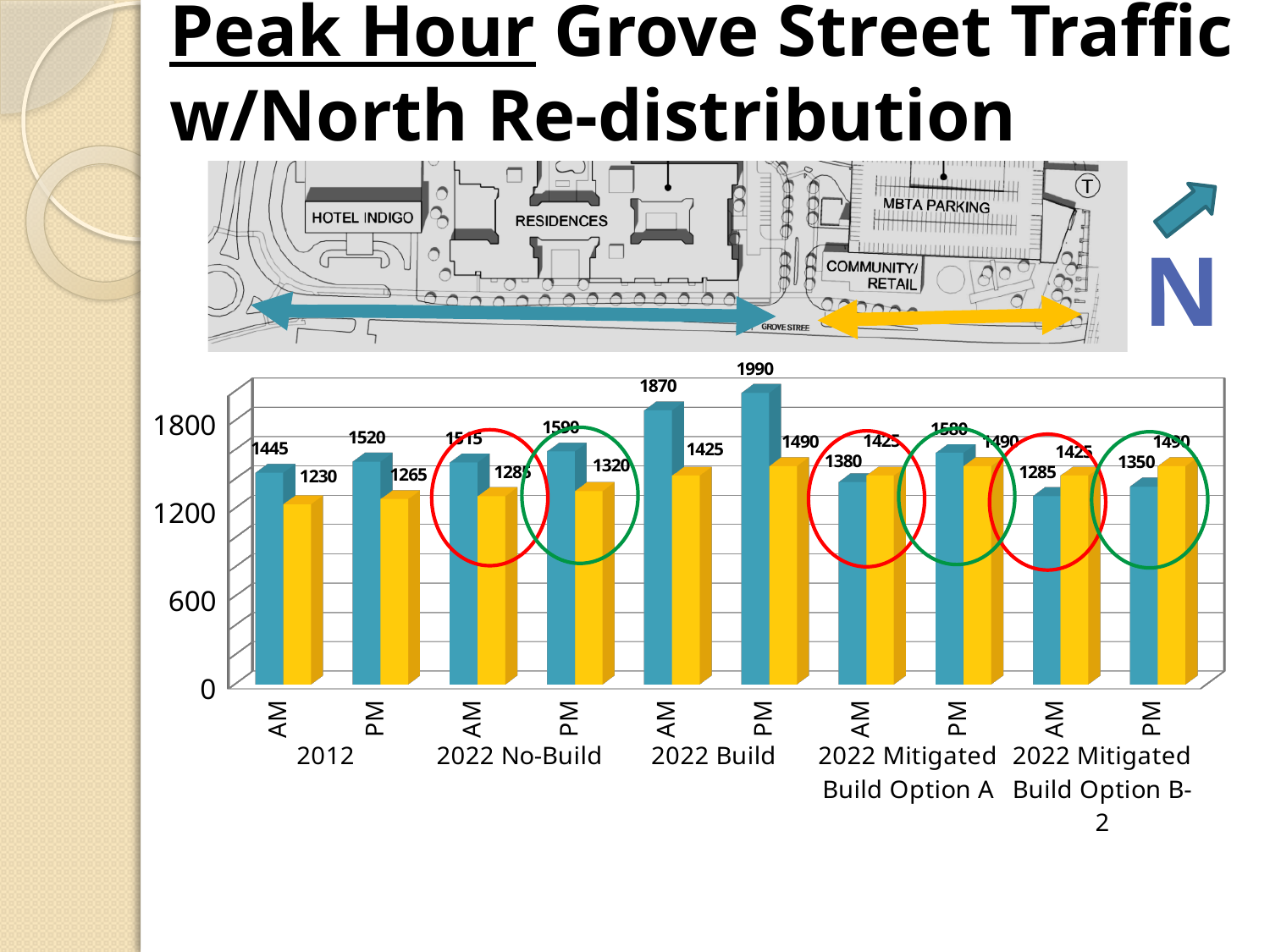
What is the value of the yellow bar for 2012 PM? 1265 What is the value of the blue bar for 2012 AM? 1445 What is the value of the blue bar for 2022 Mitigated Build Option B-2 AM? 1285 Which category has the highest blue bar? 2022 Build PM What is the difference between the blue and yellow bars for 2022 Build AM? 445 Which category has the lowest yellow bar? 2012 AM For 2022 Mitigated Build Option A AM, which bar is larger, the blue or the yellow? yellow What is the difference between the blue bar for 2022 Build AM and the blue bar for 2012 AM? 425 How many scenario groups are shown along the x axis? 5 Is the blue bar for 2022 Build PM greater or less than 1800? greater What kind of chart is shown on the slide? bar chart What is the value of the blue bar for 2022 Build PM? 1990